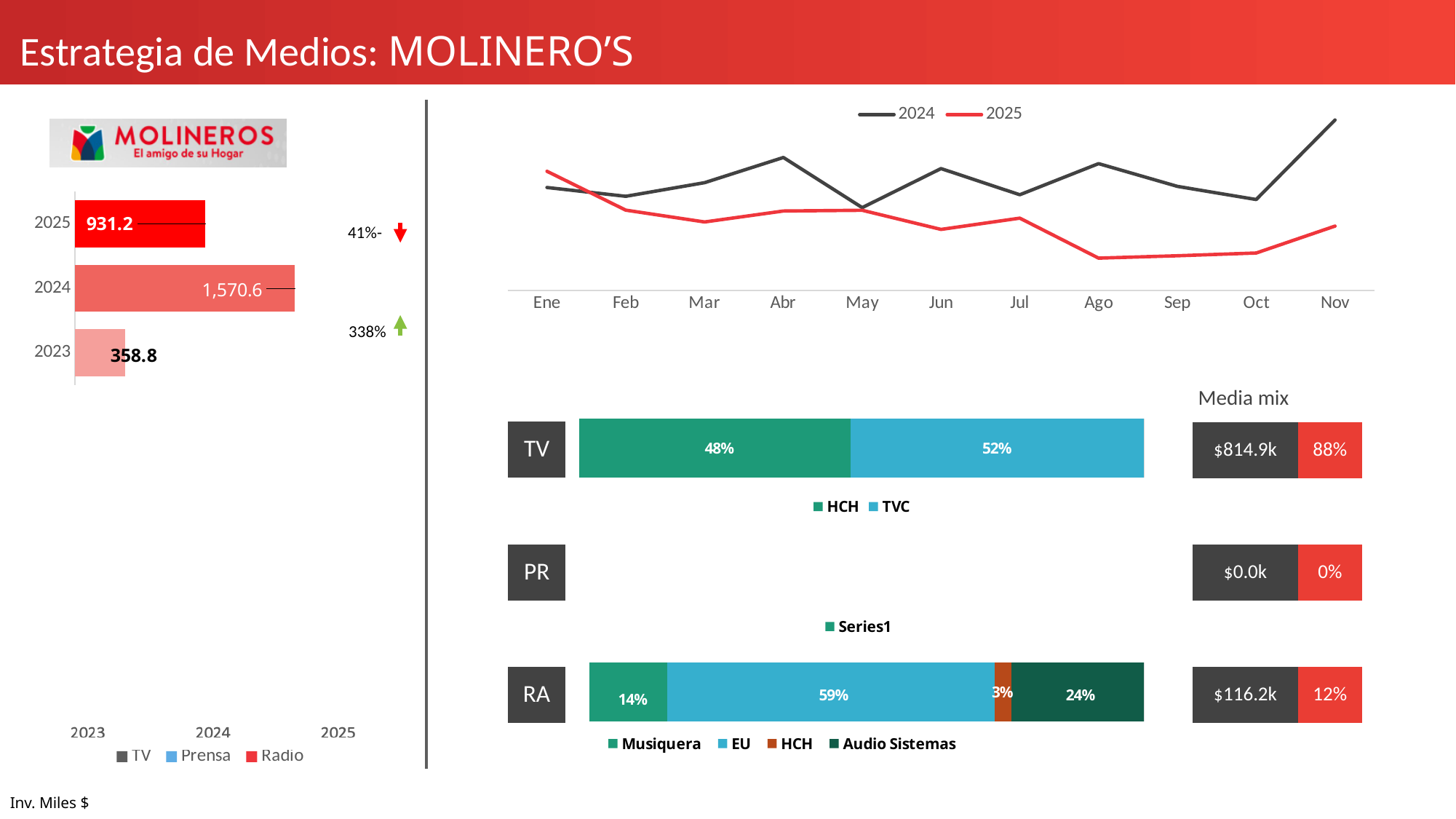
In the RA stacked bar at the bottom right, how many series does the legend list? 4 In the line chart at the top right, how many months are shown on the x axis? 11 In the line chart at the top right, how many series does the legend list? 2 In the horizontal bar chart on the left, which year has the highest value? 2024 In the horizontal bar chart on the left, what is the value for 2024? 1,570.6 In the horizontal bar chart on the left, which year has the lowest value? 2023 In the horizontal bar chart on the left, what is the difference between the 2024 and 2025 values? 639.4 In the Media mix column at the bottom right, what is the amount shown for TV? $814.9k In the TV stacked bar at the bottom right, what share does TVC have? 52% In the line chart at the top right, which series is higher in Nov, 2024 or 2025? 2024 In the RA stacked bar at the bottom right, what share does EU have? 59% In the horizontal bar chart on the left, what is the value for 2025? 931.2